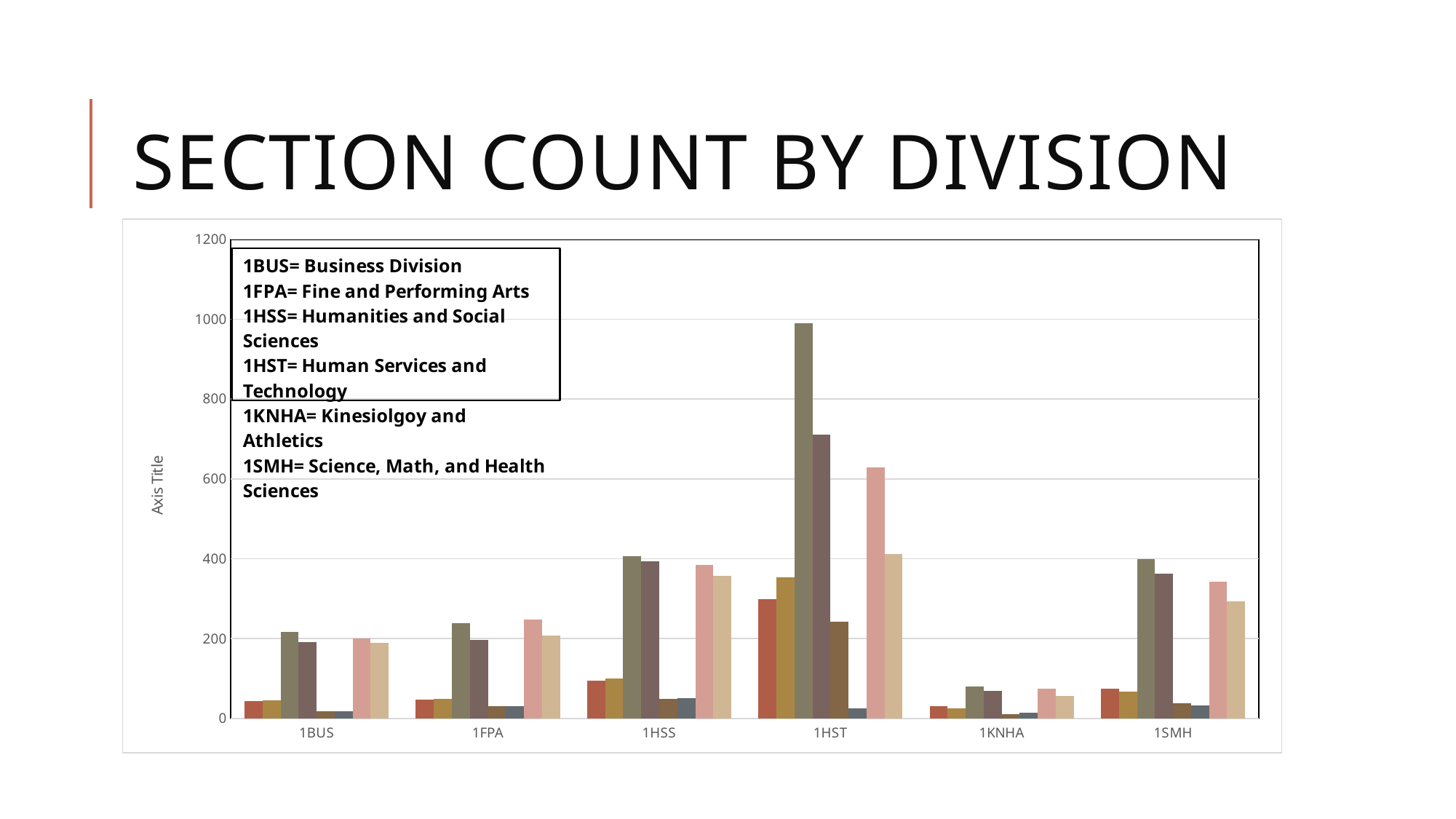
How many bars are plotted for each division category? 8 Is the tallest bar in the 1KNHA group greater or less than 200? less Is the tallest bar in the 1HST group greater or less than 800? greater Is the tallest bar in the 1HSS group greater or less than 600? less Which has the taller tallest bar, the 1HST group or the 1BUS group? 1HST Which division category contains the tallest bar in the chart? 1HST What is the highest value shown on the vertical axis? 1200 How many division categories are shown on the x axis? 6 What kind of chart is shown on the slide? bar chart What is the title of the slide containing the chart? SECTION COUNT BY DIVISION What is the label on the vertical axis? Axis Title